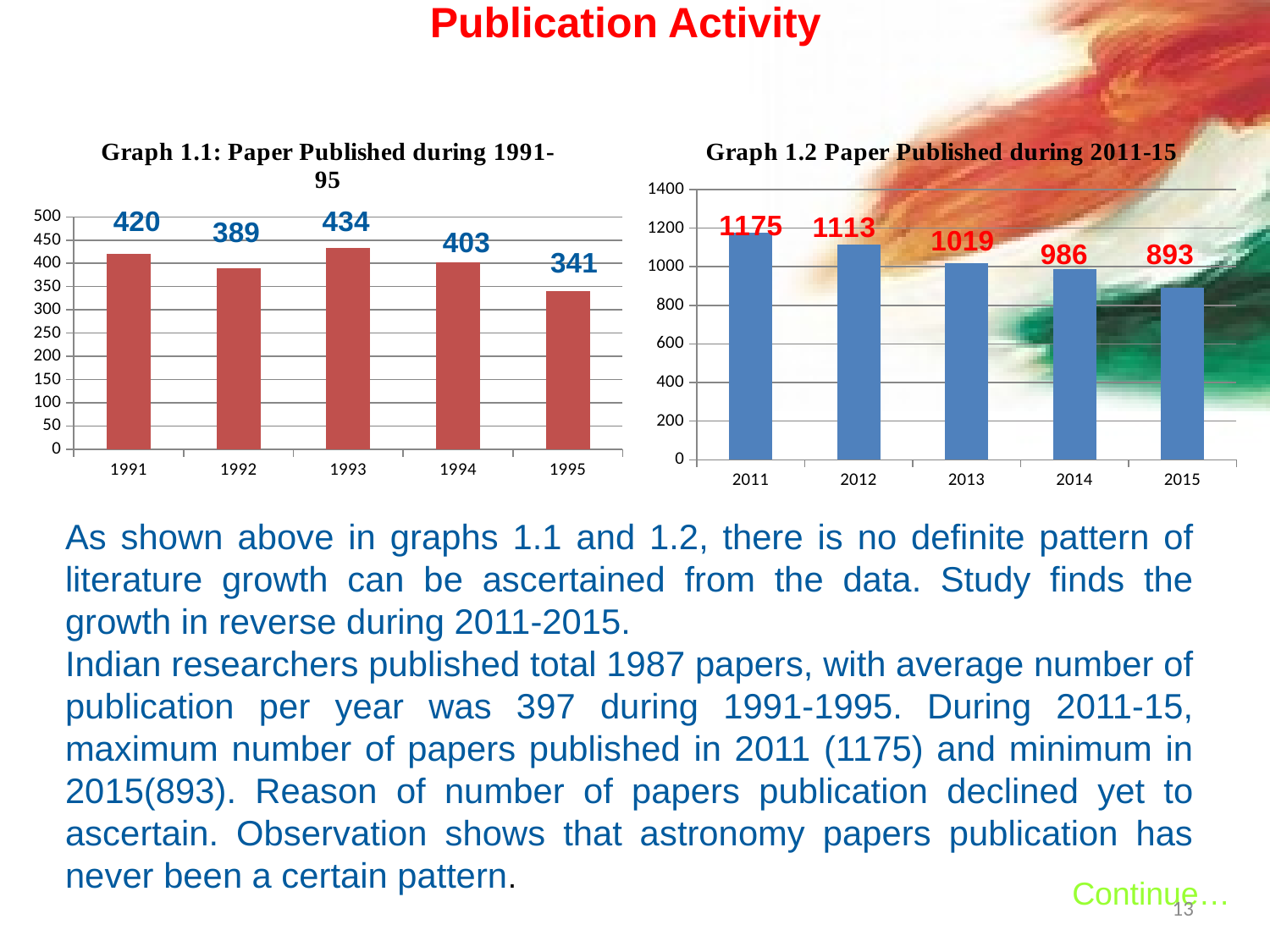
What kind of chart is Graph 1.2 (Paper Published during 2011-15)? bar chart In Graph 1.2 (Paper Published during 2011-15), how many papers were published in 2013? 1019 In Graph 1.2 (Paper Published during 2011-15), which year has the highest number of papers published? 2011 In Graph 1.1 (Paper Published during 1991-95), which year has the highest number of papers published? 1993 In Graph 1.1 (Paper Published during 1991-95), how many papers were published in 1992? 389 What colour are the bars in Graph 1.1 (Paper Published during 1991-95)? red In Graph 1.2 (Paper Published during 2011-15), do the values rise or fall from 2011 to 2015? fall In Graph 1.1 (Paper Published during 1991-95), how many years are shown on the x axis? 5 In Graph 1.2 (Paper Published during 2011-15), is the value for 2015 greater or less than 1000? less In Graph 1.1 (Paper Published during 1991-95), which year has the lowest number of papers published? 1995 In Graph 1.1 (Paper Published during 1991-95), what is the difference between the papers published in 1993 and 1995? 93 In Graph 1.2 (Paper Published during 2011-15), what is the difference between the papers published in 2011 and 2015? 282